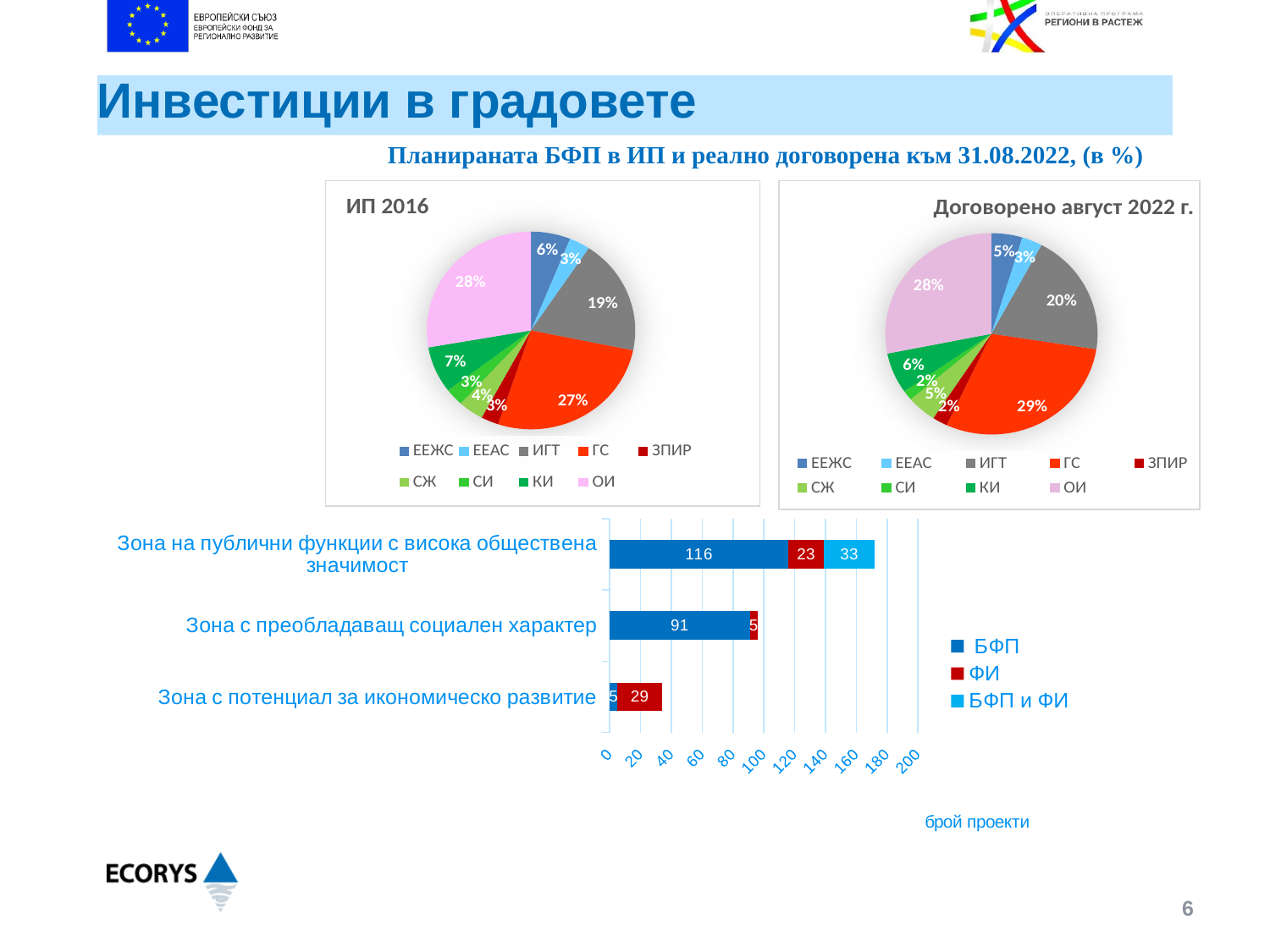
In the bar chart at the bottom of the slide, what is the БФП value for 'Зона на публични функции с висока обществена значимост'? 116 How many series does the legend of the bar chart at the bottom of the slide list? 3 How many categories does the legend of the 'ИП 2016' pie chart list? 9 In the 'ИП 2016' pie chart, what share does ИГТ have? 19% In the 'Договорено август 2022 г.' pie chart, which category has the largest share? ГС In the 'Договорено август 2022 г.' pie chart, what share does ГС have? 29% In the 'ИП 2016' pie chart, which is larger, the share of ИГТ or the share of ОИ? ОИ In the 'ИП 2016' pie chart, what share does ГС have? 27% In the 'Договорено август 2022 г.' pie chart, what share does ОИ have? 28% In the bar chart at the bottom of the slide, what is the total number of projects for 'Зона на публични функции с висока обществена значимост'? 172 In the bar chart at the bottom of the slide, what is the ФИ value for 'Зона с потенциал за икономическо развитие'? 29 What kind of chart is the chart at the bottom of the slide? Bar chart